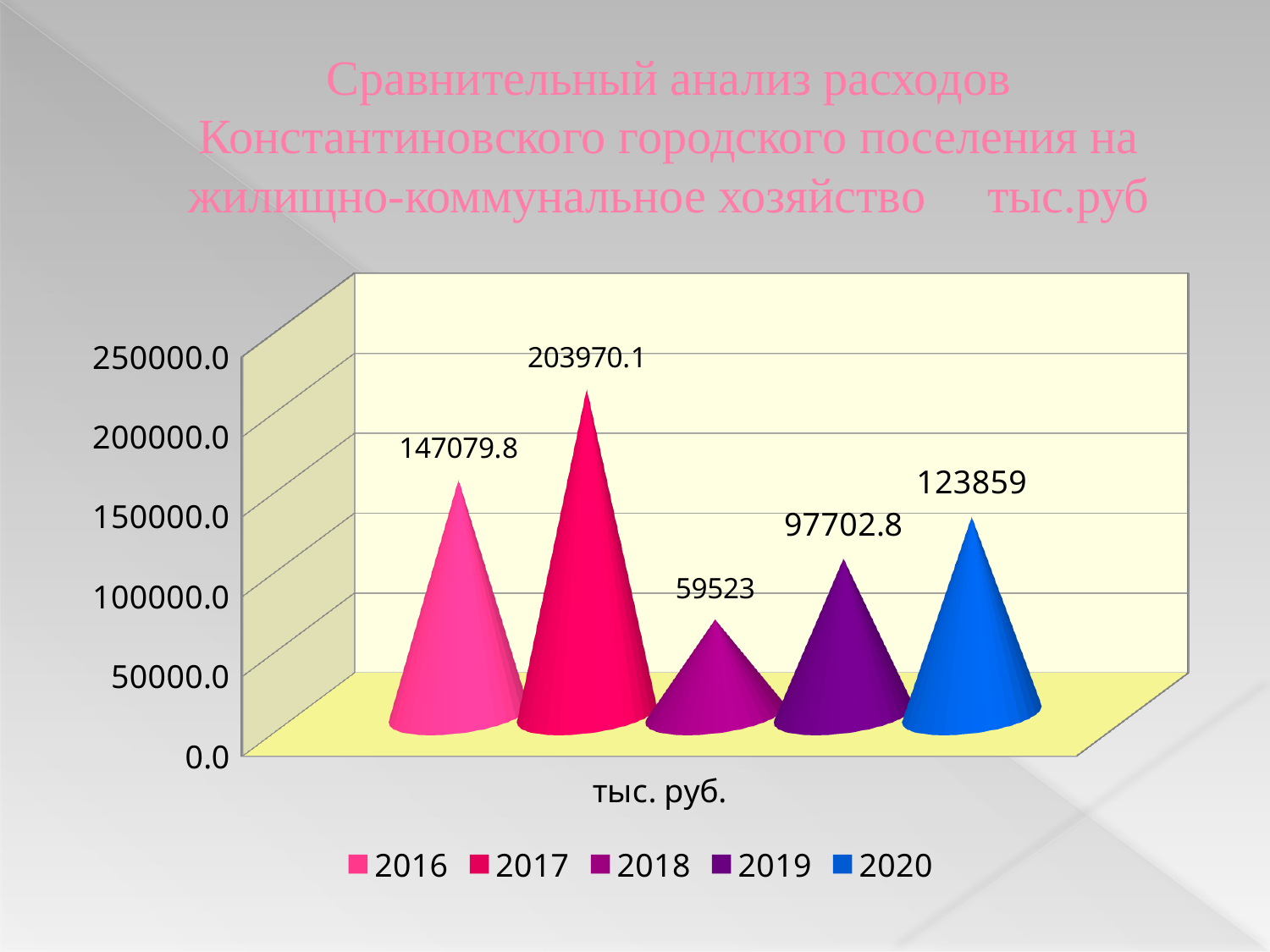
What is the difference between the values for 2017 and 2016? 56890.3 What is the difference between the values for 2020 and 2018? 64336 Which year has the lowest value? 2018 Is the value for 2019 greater or less than 100000.0? less What is the value for 2020? 123859 What is the value for 2018? 59523 What kind of chart is shown on the slide? bar chart What is the value for 2017? 203970.1 How many series does the legend list? 5 Which year has the highest value? 2017 Which is larger, the value for 2019 or the value for 2020? 2020 What is the value for 2016? 147079.8